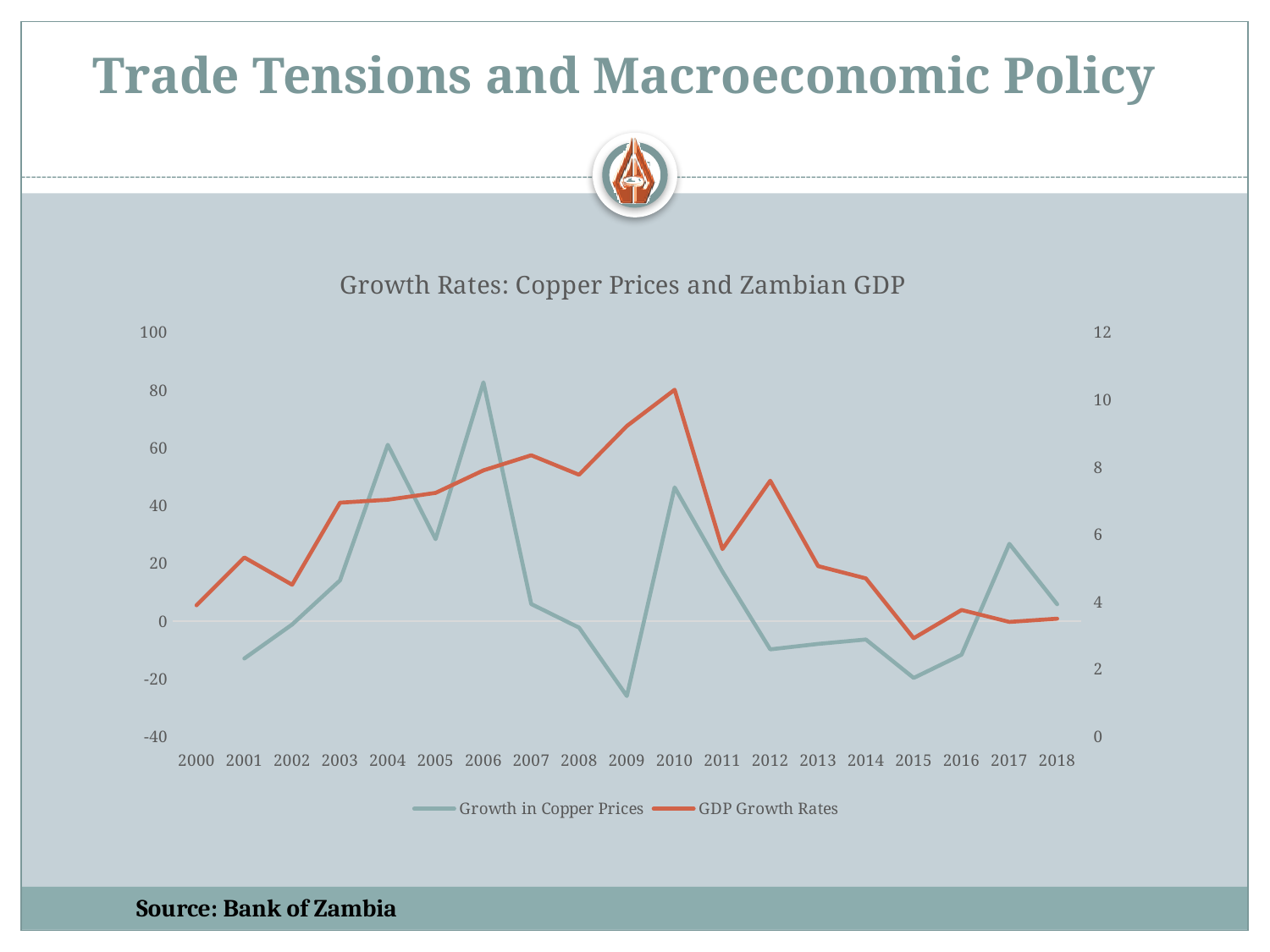
In which year does Growth in Copper Prices reach its highest value? 2006 In which year is the GDP Growth Rate highest? 2010 Is the value for Growth in Copper Prices in 2006 greater or less than 60? greater Which year has the larger Growth in Copper Prices, 2006 or 2010? 2006 Is the value for Growth in Copper Prices in 2009 greater or less than -20? less How many series does the legend list? 2 Is the GDP Growth Rate in 2010 greater or less than 8 on the right axis? greater What is the title of the chart? Growth Rates: Copper Prices and Zambian GDP How many years are shown on the x axis? 19 Does the GDP Growth Rate rise or fall from 2012 to 2015? fall What kind of chart is shown on the slide? Line chart In which year does Growth in Copper Prices reach its lowest value? 2009